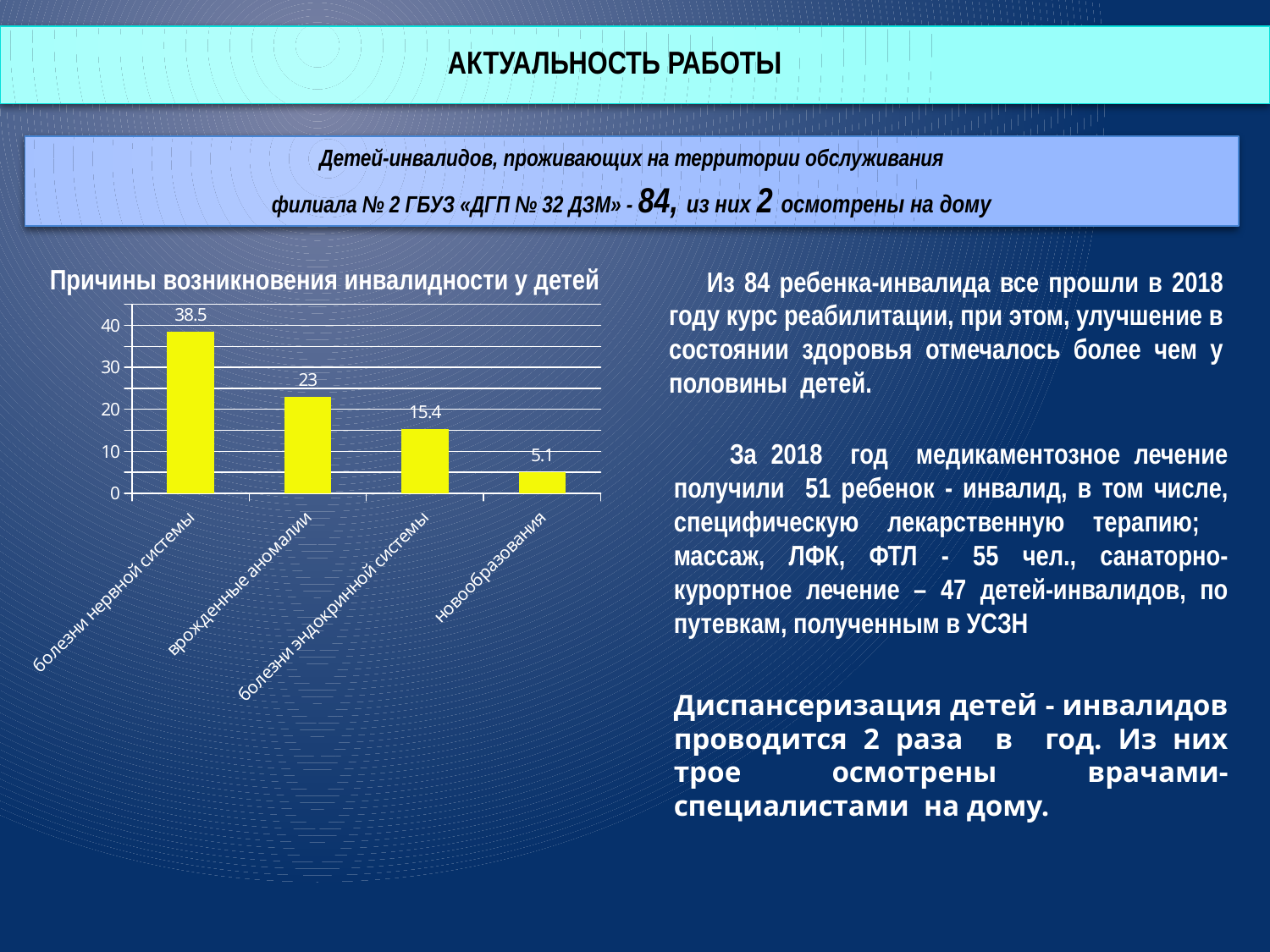
How many categories are shown in the chart? 4 What kind of chart is shown on the slide? bar chart What is the value for болезни нервной системы? 38.5 Which is larger, the value for врожденные аномалии or the value for болезни эндокринной системы? врожденные аномалии What is the value for новообразования? 5.1 What is the title of the chart? Причины возникновения инвалидности у детей What is the value for болезни эндокринной системы? 15.4 Is the value for болезни эндокринной системы greater or less than 20? less Which category has the lowest value? новообразования Which category has the highest value? болезни нервной системы What is the difference between the values for болезни нервной системы and врожденные аномалии? 15.5 What is the value for врожденные аномалии? 23